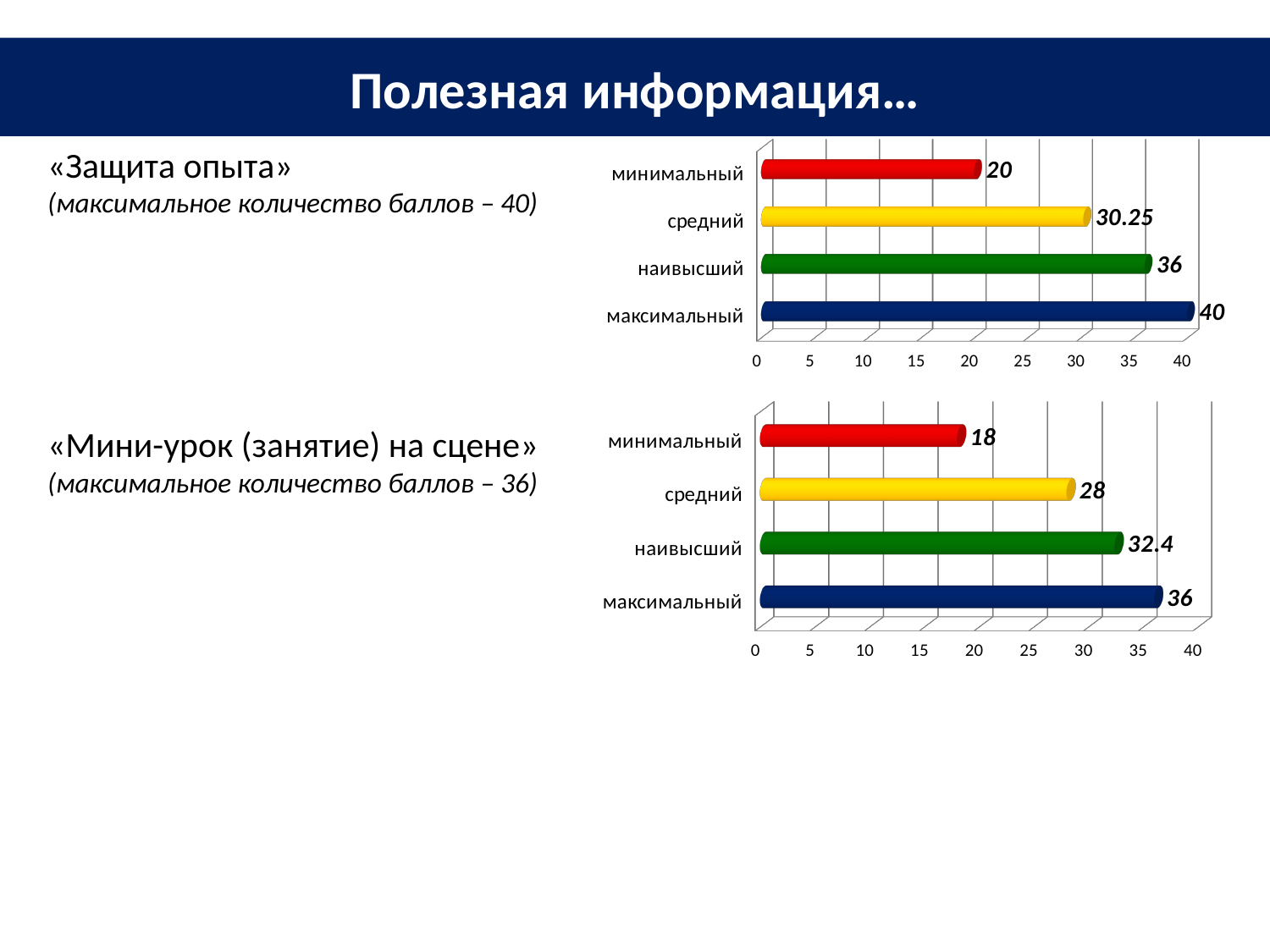
In the bottom chart («Мини-урок (занятие) на сцене»), which category has the lowest value? минимальный In the bottom chart («Мини-урок (занятие) на сцене»), what is the value for наивысший? 32.4 In the top chart («Защита опыта»), what is the value for средний? 30.25 In the top chart («Защита опыта»), what is the value for минимальный? 20 In the top chart («Защита опыта»), what colour is the bar for наивысший? green In the bottom chart («Мини-урок (занятие) на сцене»), what is the value for средний? 28 In the top chart («Защита опыта»), which category has the highest value? максимальный In the bottom chart («Мини-урок (занятие) на сцене»), which is larger, наивысший or средний? наивысший How many categories are shown in the top chart («Защита опыта»)? 4 What kind of chart is the bottom chart («Мини-урок (занятие) на сцене»)? bar chart In the top chart («Защита опыта»), what is the difference between максимальный and наивысший? 4 In the bottom chart («Мини-урок (занятие) на сцене»), what is the difference between средний and минимальный? 10